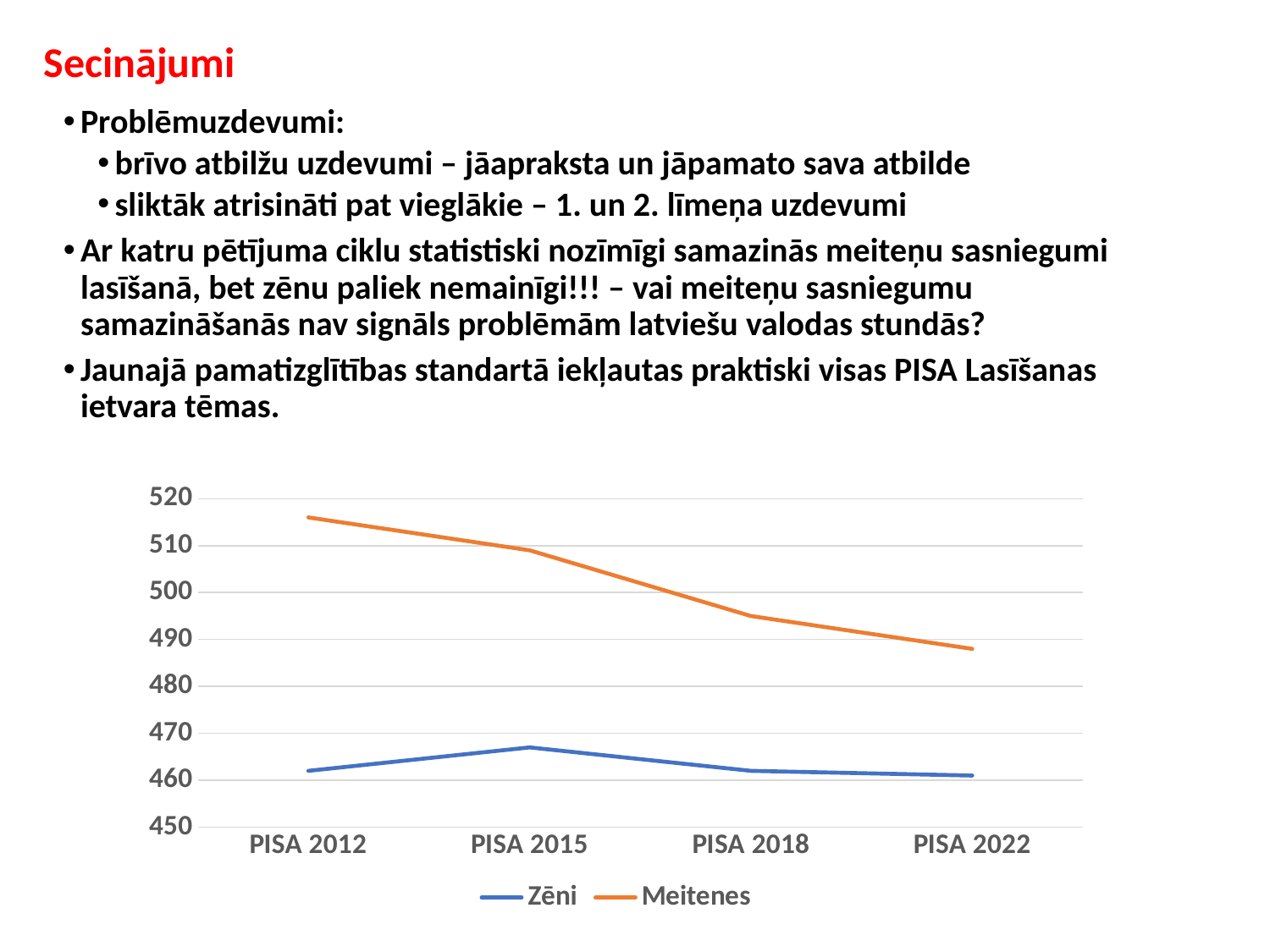
How many PISA cycles are plotted along the x axis? 4 Does the Meitenes line rise or fall from PISA 2012 to PISA 2022? fall Is the Meitenes value for PISA 2022 greater or less than 490? less In which PISA cycle is the Zēni value highest? PISA 2015 What kind of chart is shown on the slide? line chart Which series is drawn in orange? Meitenes Is the Meitenes value for PISA 2012 greater or less than 510? greater In which PISA cycle is the Meitenes value highest? PISA 2012 How many series does the chart legend list? 2 Is the Zēni value for PISA 2015 greater or less than 460? greater Which series has the larger value in PISA 2018, Zēni or Meitenes? Meitenes In which PISA cycle is the Meitenes value lowest? PISA 2022